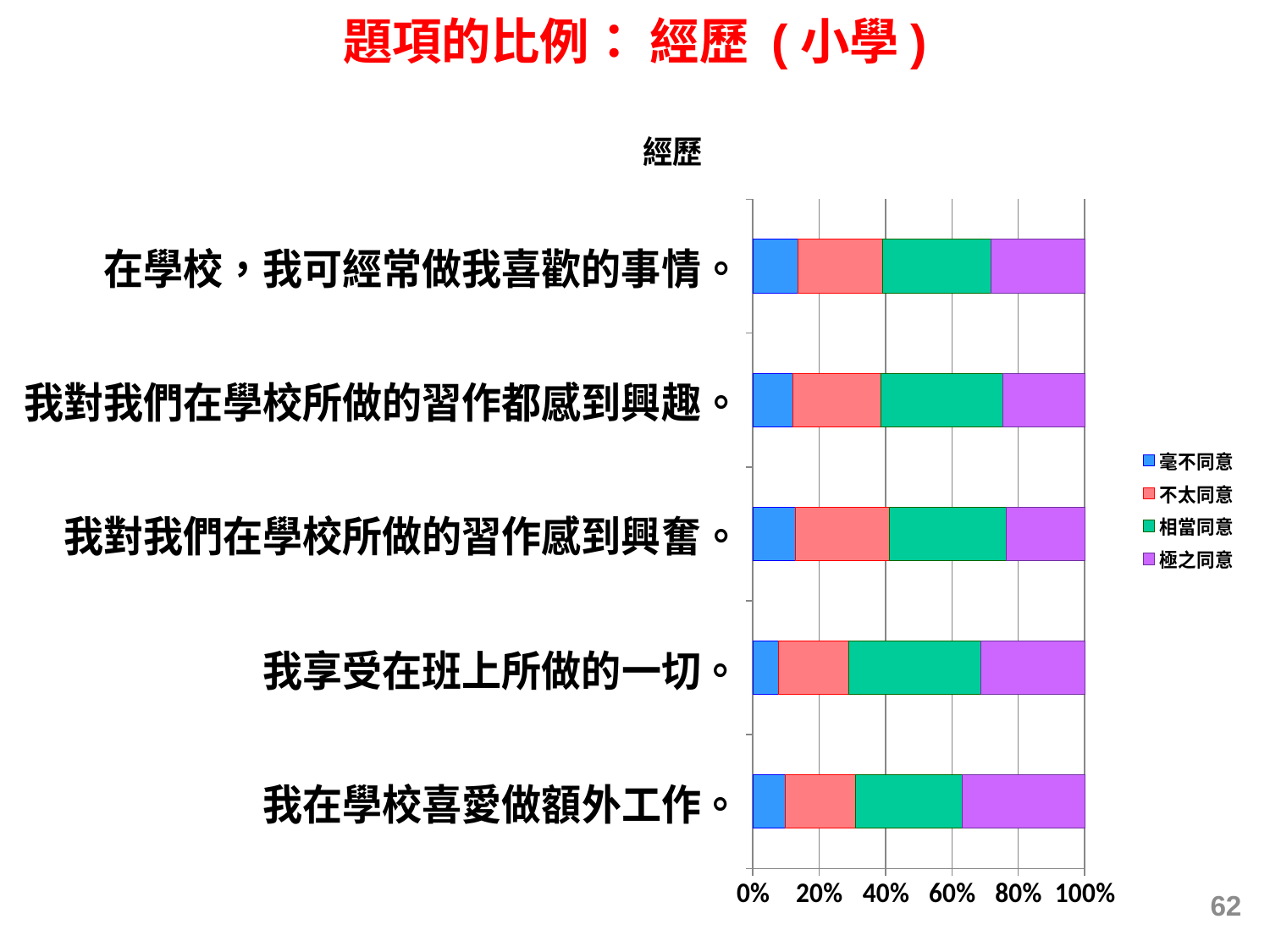
Which statement has the largest 極之同意 share? 我在學校喜愛做額外工作 How many series does the legend list? 4 Is the 毫不同意 value for 我享受在班上所做的一切 greater or less than 20%? less Which legend entry is shown in purple? 極之同意 How many statements (categories) are plotted in the chart? 5 Is the 相當同意 value for 我享受在班上所做的一切 greater or less than 20%? greater What kind of chart is shown on the slide? stacked bar chart Is the 極之同意 value for 我在學校喜愛做額外工作 greater or less than 20%? greater Which has the larger 極之同意 share: 我在學校喜愛做額外工作 or 我對我們在學校所做的習作都感到興趣? 我在學校喜愛做額外工作 What is the title of the chart? 經歷 Which has the larger 毫不同意 share: 在學校，我可經常做我喜歡的事情 or 我享受在班上所做的一切? 在學校，我可經常做我喜歡的事情